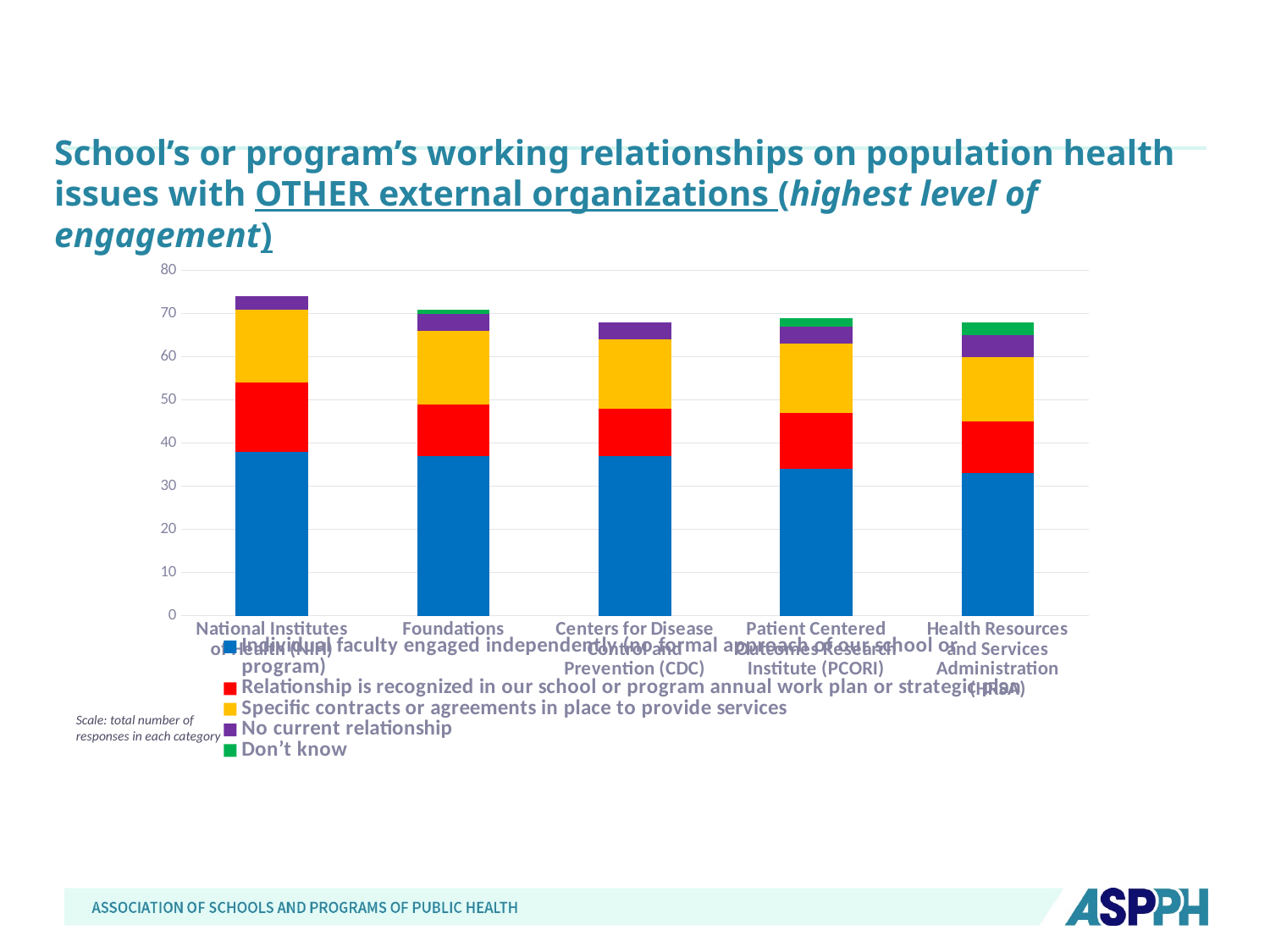
Which organization has the tallest stacked bar overall? National Institutes of Health (NIH) What colour represents the 'Don't know' series in the legend? green Is the total stacked bar for Centers for Disease Control and Prevention (CDC) greater or less than 70? less Which series forms the bottom segment of each stacked bar? Individual faculty engaged independently (no formal approach of our school or program) How many external organizations (categories) are shown on the x axis? 5 Is the 'Individual faculty engaged independently' segment for Health Resources and Services Administration (HRSA) greater or less than 30? greater Is the total stacked bar for National Institutes of Health (NIH) greater or less than 70? greater How many series does the legend list? 5 Which has the larger 'Individual faculty engaged independently' segment: National Institutes of Health (NIH) or Health Resources and Services Administration (HRSA)? National Institutes of Health (NIH) What kind of chart is shown on the slide? stacked bar chart Which has the larger total stacked bar: National Institutes of Health (NIH) or Centers for Disease Control and Prevention (CDC)? National Institutes of Health (NIH)